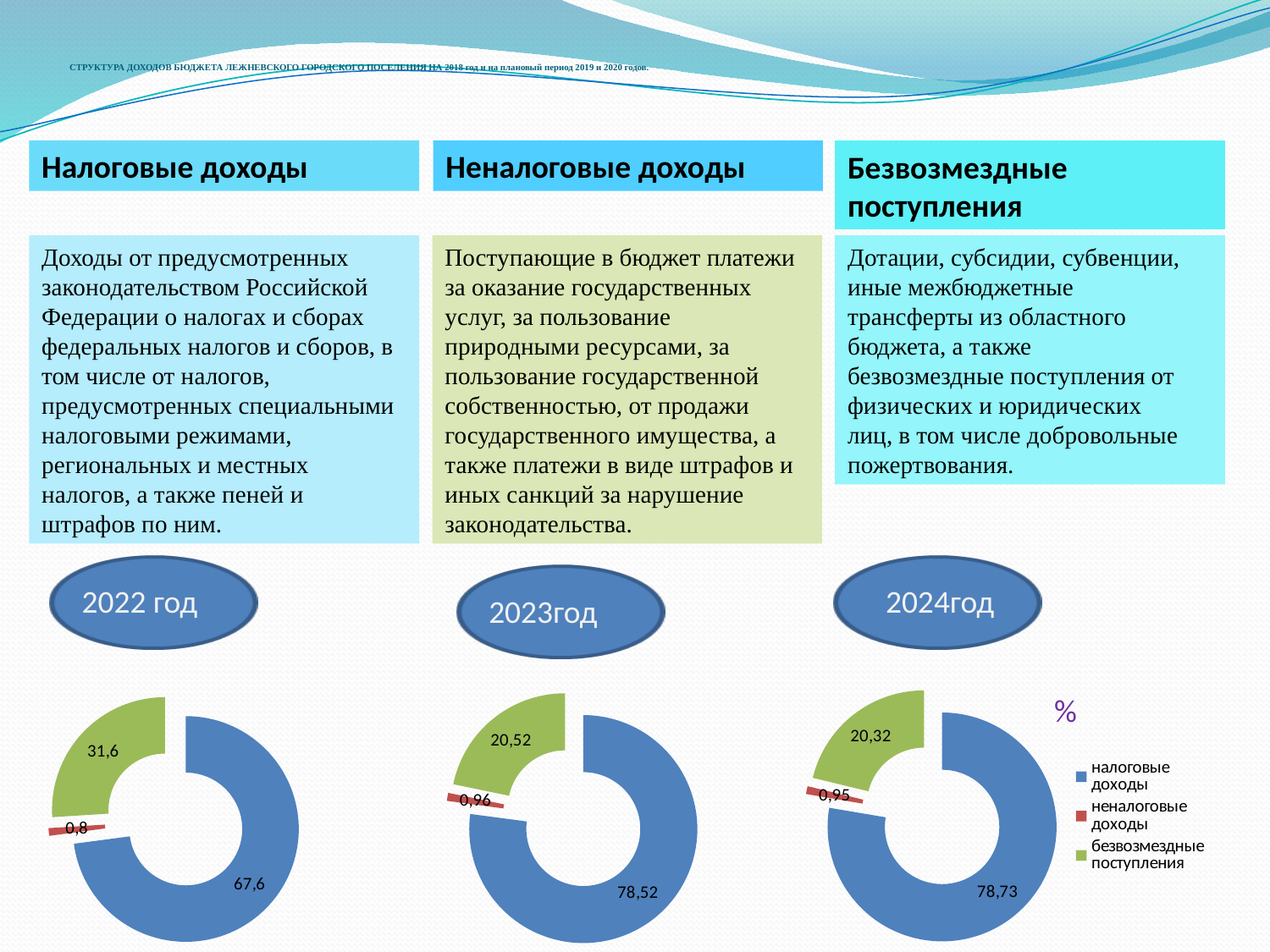
How many categories does each doughnut chart show? 3 In the 2022 год chart, which category has the largest share? налоговые доходы Is the value for налоговые доходы in the 2023год chart greater or less than the value for налоговые доходы in the 2022 год chart? greater Which colour represents безвозмездные поступления in the charts? green In the 2024год chart, what is the difference between налоговые доходы and безвозмездные поступления? 58,41 What kind of chart is used for the 2023год data? doughnut chart How many series does the legend list? 3 Which is larger in the 2022 год chart: безвозмездные поступления or неналоговые доходы? безвозмездные поступления In the 2024год chart, what is the value for неналоговые доходы? 0,95 In the 2023год chart, what is the value for безвозмездные поступления? 20,52 In the 2022 год chart, what is the value for налоговые доходы? 67,6 In the 2023год chart, which category has the smallest share? неналоговые доходы